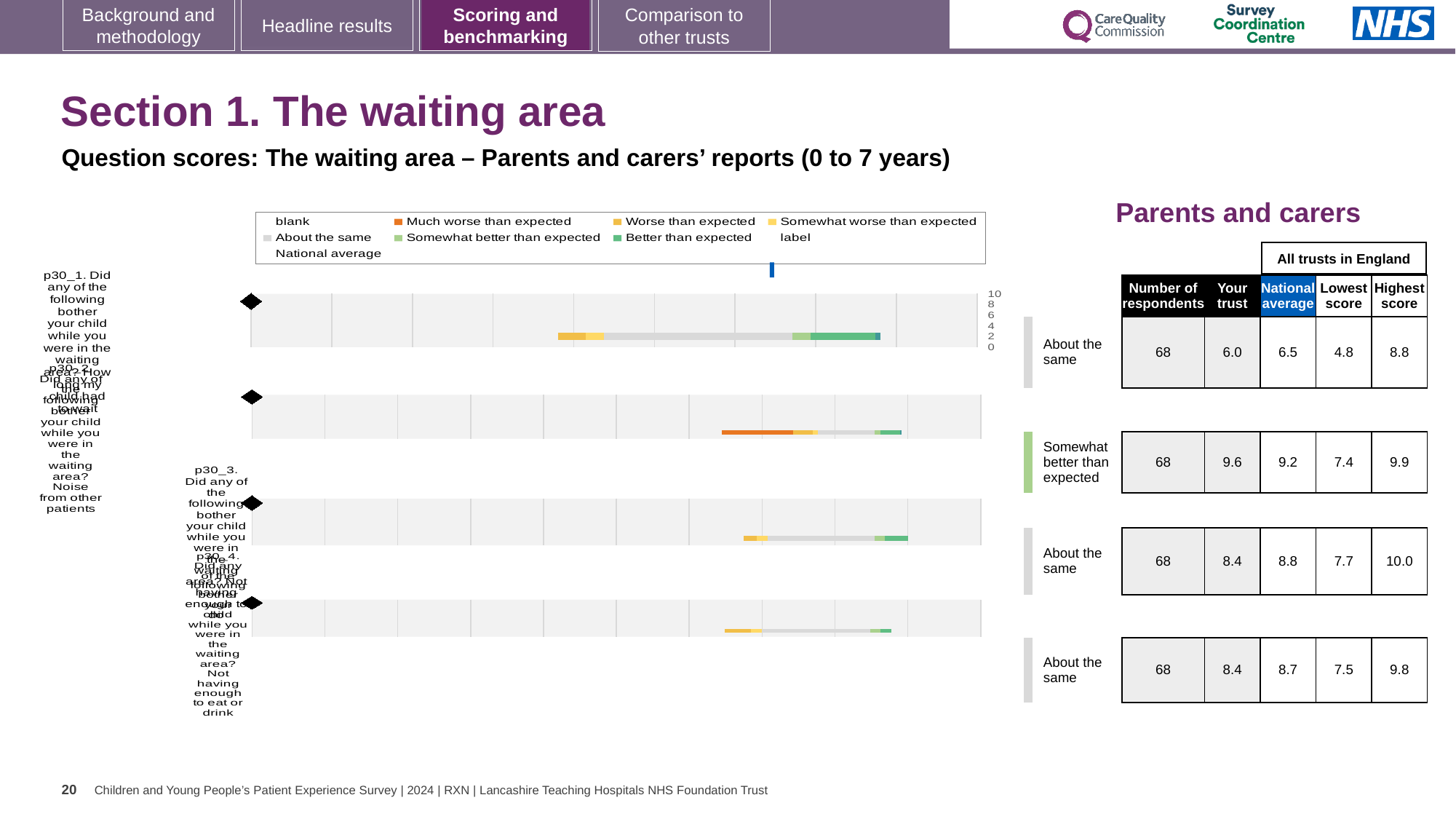
In the table beside the chart, what is the highest score for the third row (p30_3)? 10.0 In the table beside the chart, what is the 'Your trust' score for the second row (p30_2)? 9.6 In the table beside the chart, what is the lowest score for the fourth row (p30_4)? 7.5 In the table beside the chart, what is the difference between 'Your trust' and 'National average' for the second row (p30_2)? 0.4 In the table beside the chart, which row has the lowest 'Your trust' score? the first row (p30_1), 6.0 In the chart legend, what colour represents 'Better than expected'? green In the chart legend, what colour represents 'Much worse than expected'? orange In the table beside the chart, what is the number of respondents for the first row (p30_1)? 68 What kind of chart is shown on the slide? bar chart In the table beside the chart, which row has the highest 'Your trust' score? the second row (p30_2), 9.6 How many question rows (bars) does the chart show? 4 In the table beside the chart, for the second row (p30_2), which is larger: 'Your trust' or 'National average'? Your trust